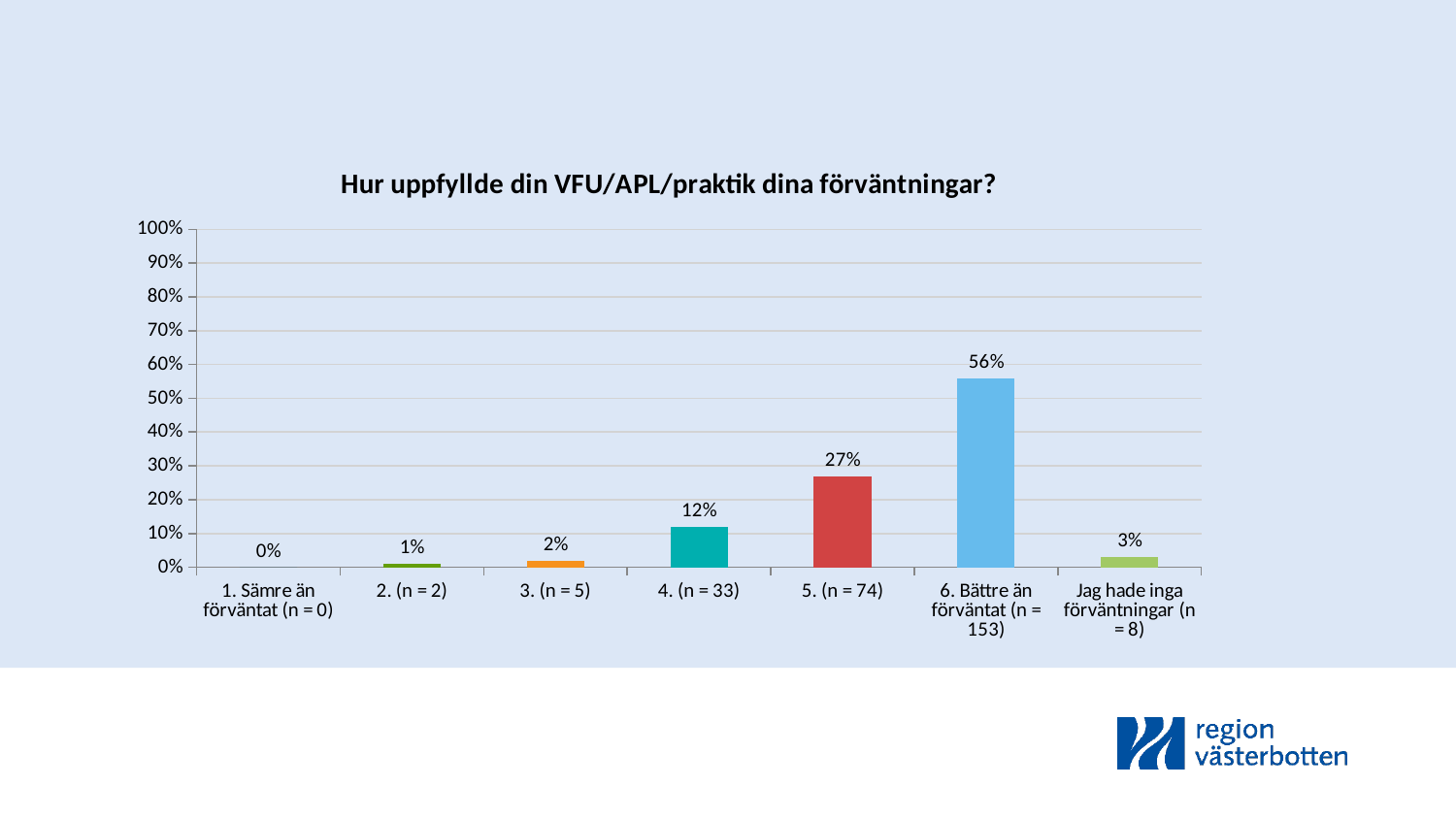
Is the value for "6. Bättre än förväntat (n = 153)" greater or less than 50%? greater What is the title of the chart? Hur uppfyllde din VFU/APL/praktik dina förväntningar? Which category has the lowest value? 1. Sämre än förväntat (n = 0) What is the value for "Jag hade inga förväntningar (n = 8)"? 3% Which is larger, the value for "4. (n = 33)" or the value for "Jag hade inga förväntningar (n = 8)"? 4. (n = 33) What is the value for "4. (n = 33)"? 12% What is the value for "6. Bättre än förväntat (n = 153)"? 56% What is the value for "5. (n = 74)"? 27% What is the difference between the values for "6. Bättre än förväntat (n = 153)" and "5. (n = 74)"? 29% What kind of chart is shown on the slide? bar chart Which category has the highest value? 6. Bättre än förväntat (n = 153) How many categories are shown on the x axis? 7